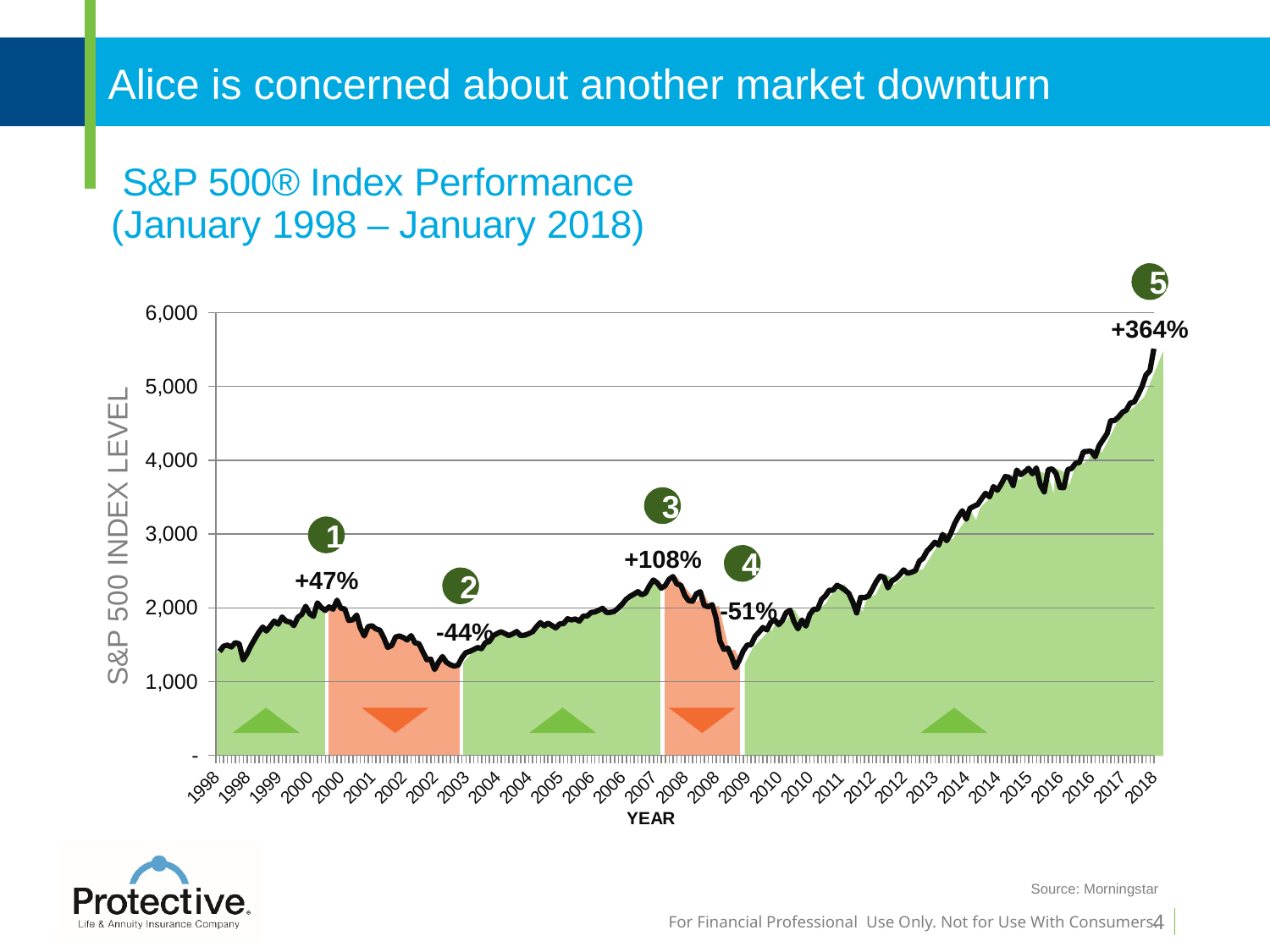
Is the S&P 500 index level at the end of the chart (January 2018) greater or less than 5,000? greater What percentage change is labelled for period 4 on the chart? -51% What percentage change is labelled for period 3 on the chart? +108% What percentage change is labelled for period 2 on the chart? -44% What kind of chart is shown on the slide? Line chart with shaded area What percentage change is labelled for period 1 on the chart? +47% Which numbered period shows the largest percentage gain? Period 5 (+364%) What is the label on the y-axis of the chart? S&P 500 INDEX LEVEL Which decline was larger, the one labelled -44% or the one labelled -51%? -51% What percentage change is labelled for period 5 on the chart? +364% How many numbered periods are marked on the chart? 5 What is the title of the chart? S&P 500® Index Performance (January 1998 – January 2018)